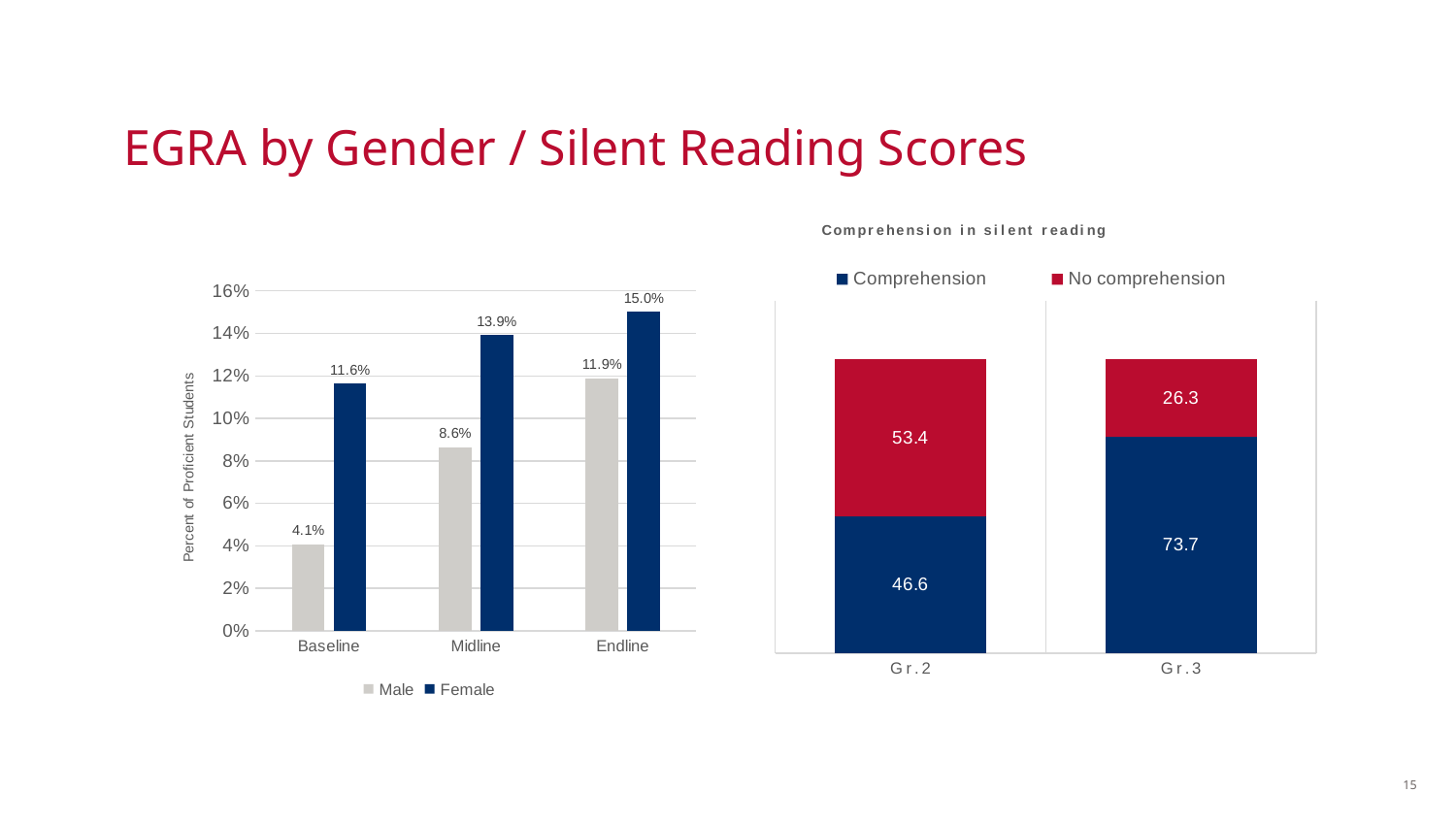
What kind of chart is the 'Comprehension in silent reading' chart? stacked bar chart In the 'Comprehension in silent reading' chart, what is the No comprehension value for Gr.2? 53.4 In the left chart, do the Male values rise or fall from Baseline to Endline? rise In the 'Comprehension in silent reading' chart, what is the total of the stacked bar for Gr.2? 100 In the 'Comprehension in silent reading' chart, what is the Comprehension value for Gr.3? 73.7 In the left chart, what is the value for Male at Midline? 8.6% In the left chart, what is the difference between the Female and Male values at Endline? 3.1% In the left chart, which category has the lowest Male value? Baseline In the left chart, what is the value for Female at Baseline? 11.6% In the 'Comprehension in silent reading' chart, which is larger for Gr.3: Comprehension or No comprehension? Comprehension In the left chart, how many series does the legend list? 2 In the left chart, which category has the highest Female value? Endline